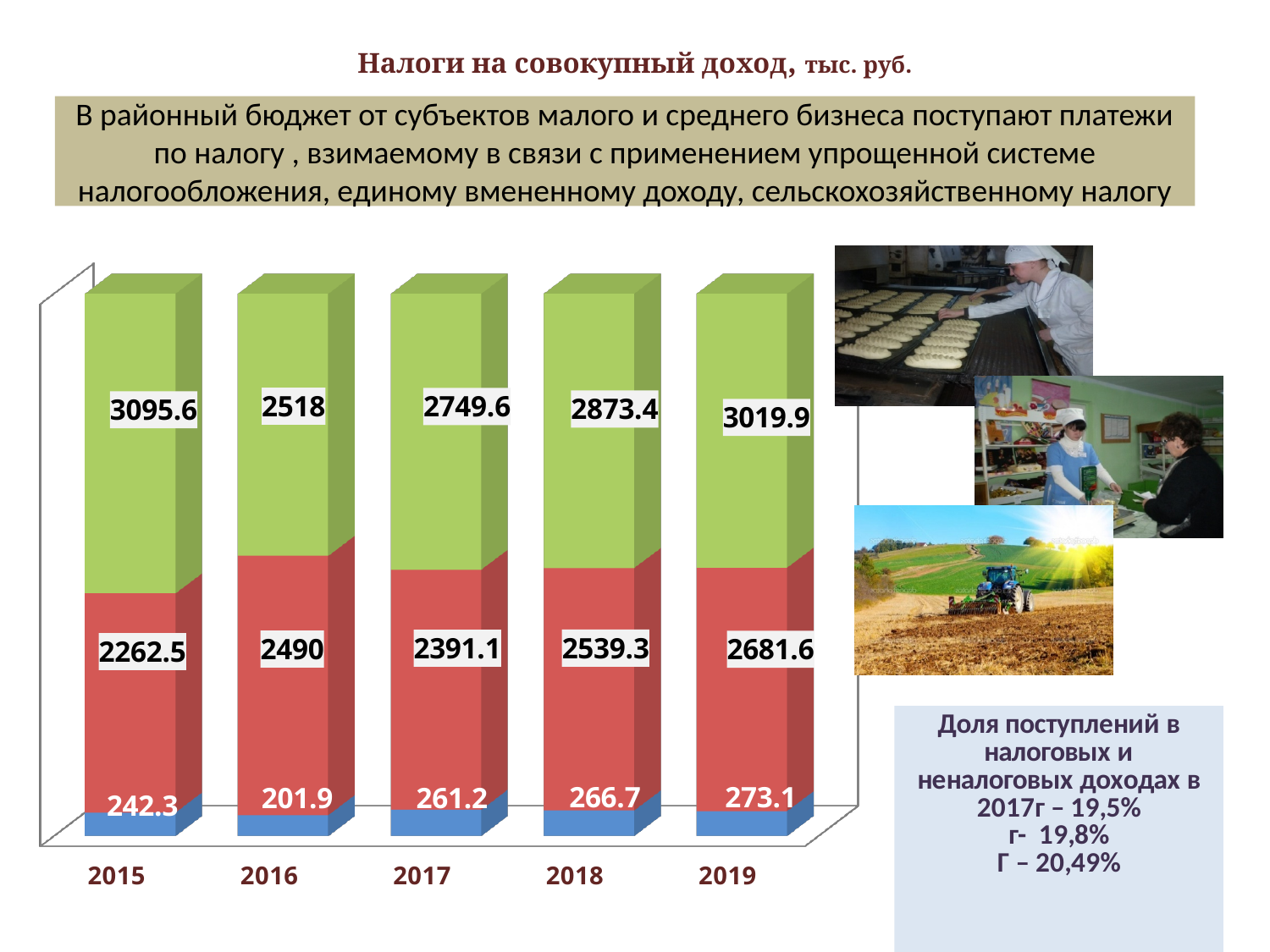
What is the value of the blue (bottom) segment for 2016? 201.9 What is the title of the chart on the slide? Налоги на совокупный доход, тыс. руб. What is the total of the stacked bar for 2019? 5974.6 Which is larger: the green segment for 2016 or the green segment for 2018? 2018 What kind of chart is shown on the slide? stacked bar chart What is the value of the red (middle) segment for 2019? 2681.6 What is the value of the green (top) segment for 2017? 2749.6 In which year is the blue (bottom) segment the lowest? 2016 What is the difference between the red (middle) segment values for 2019 and 2018? 142.3 Do the values of the red (middle) segment rise or fall from 2017 to 2019? rise How many years (categories) are shown on the x axis of the chart? 5 In which year is the green (top) segment the highest? 2015